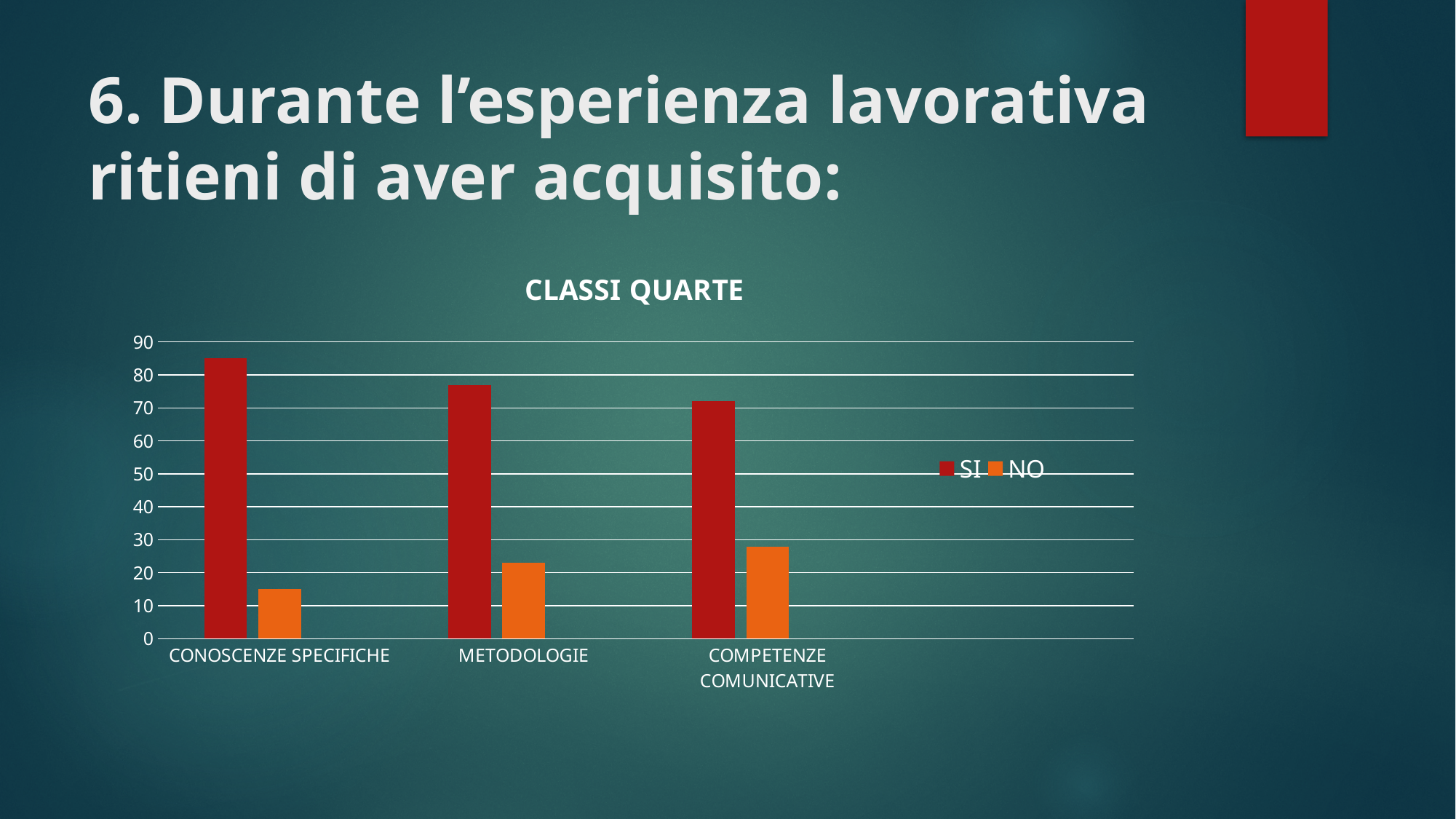
Which is larger for METODOLOGIE, the SI value or the NO value? SI What is the title of the chart? CLASSI QUARTE Which category has the lowest NO value? CONOSCENZE SPECIFICHE Is the NO value for METODOLOGIE greater or less than 30? less Which category has the highest SI value? CONOSCENZE SPECIFICHE Which category has the highest NO value? COMPETENZE COMUNICATIVE How many series does the legend list? 2 How many categories are shown on the x axis? 3 Is the SI value for CONOSCENZE SPECIFICHE greater or less than 80? greater Is the SI value for COMPETENZE COMUNICATIVE greater or less than 70? greater What kind of chart is shown on the slide? bar chart Do the SI values rise or fall from left to right across the categories? fall